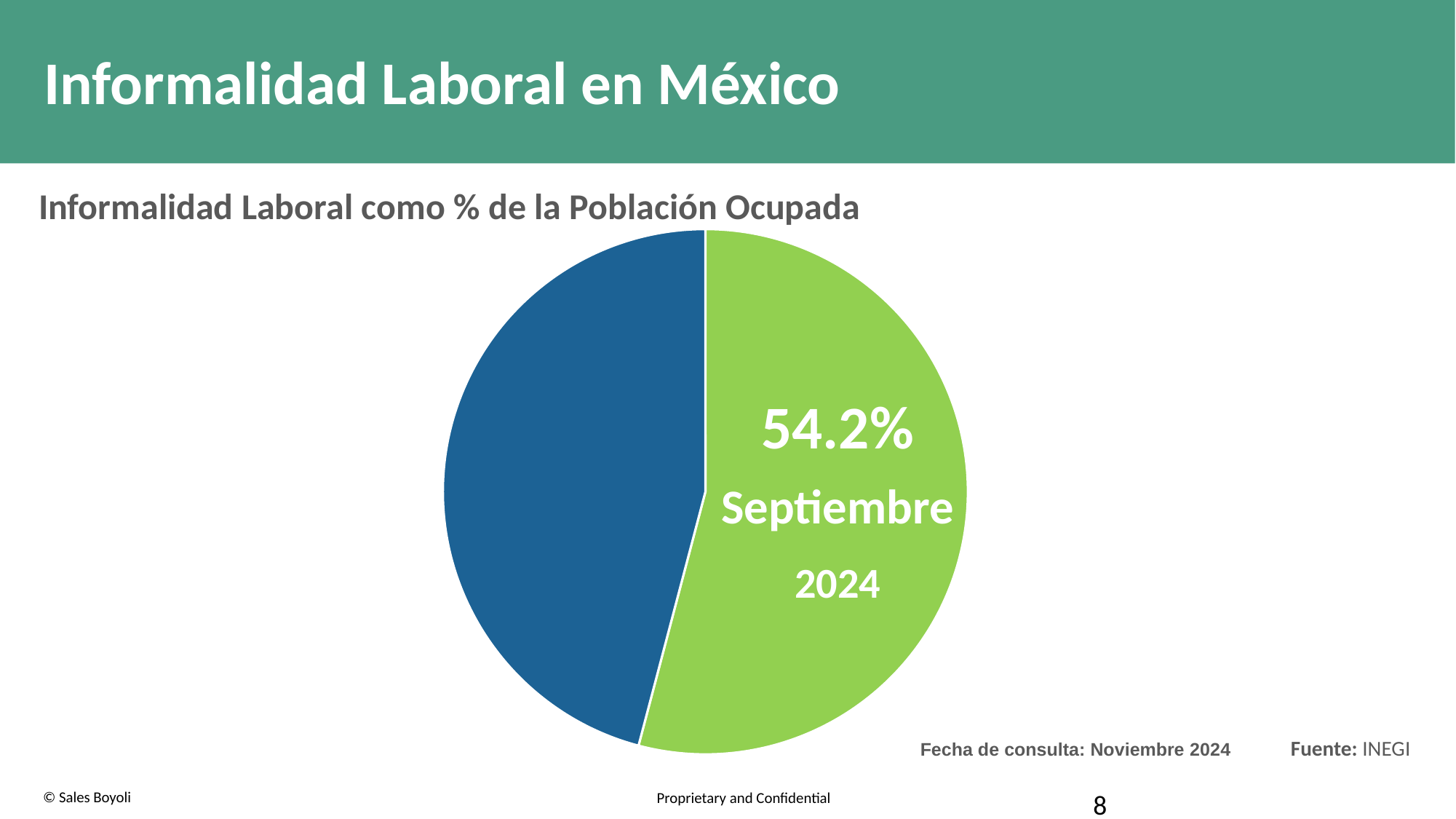
How many slices does the pie chart have? 2 Which slice is the largest in the pie chart? The green slice (Septiembre 2024, 54.2%) Which month and year is labeled on the pie chart? Septiembre 2024 What colour is the slice labeled 54.2%? Green What kind of chart is shown on the slide? Pie chart What value is printed on the green slice of the pie chart? 54.2% What is the title of the chart? Informalidad Laboral como % de la Población Ocupada What share of the pie does the Septiembre 2024 slice represent? 54.2% Is the value for Septiembre 2024 greater or less than 50%? greater Which slice of the pie chart is larger, the green one or the blue one? The green one